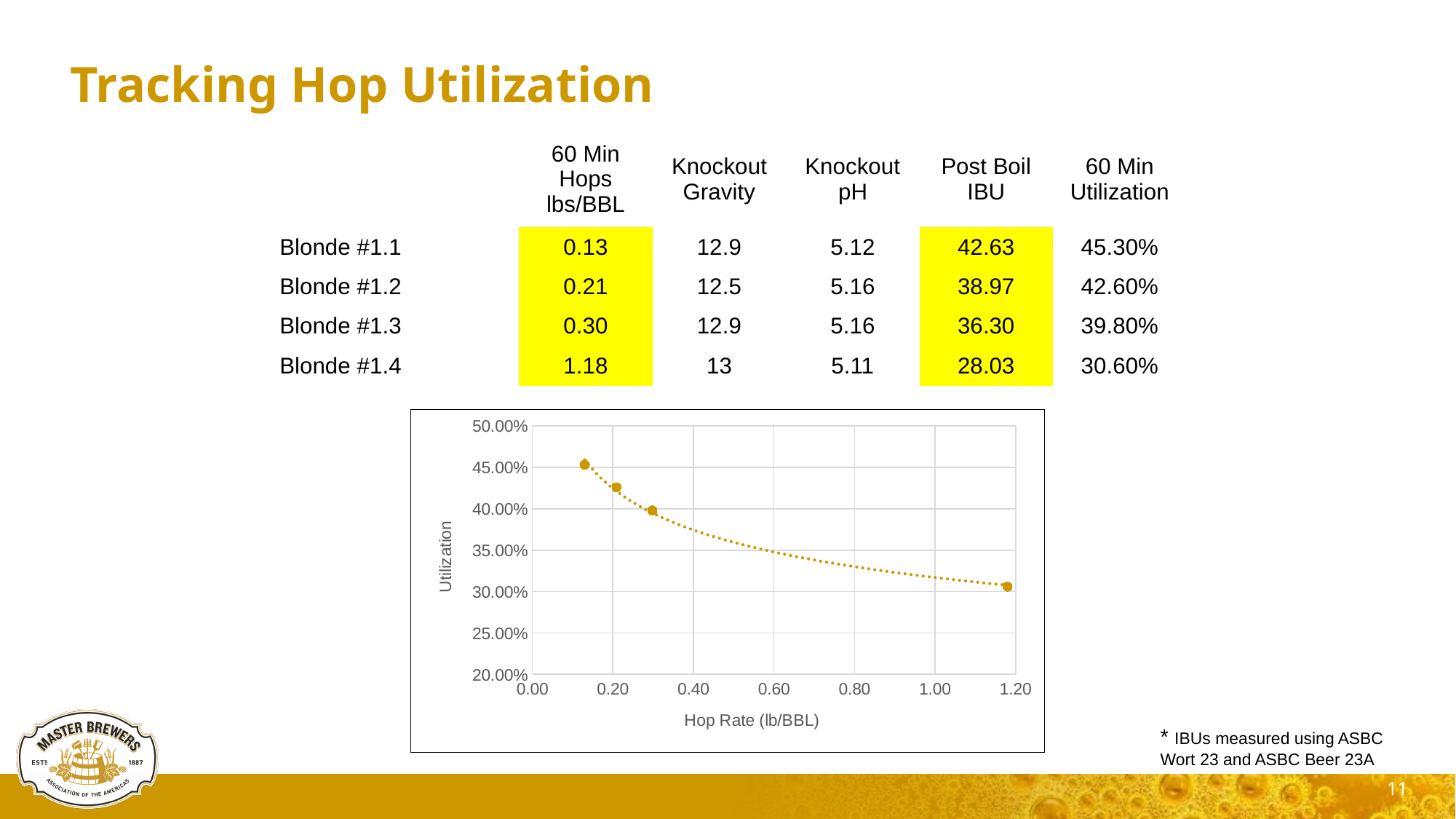
How many data points are plotted on the chart? 4 What is the utilization at a hop rate of 1.18 lb/BBL? 30.60% Which hop rate gives the lowest utilization on the chart? 1.18 Does utilization rise or fall as hop rate increases along the x axis? fall Which hop rate gives the highest utilization on the chart? 0.13 What is the utilization at a hop rate of 0.30 lb/BBL? 39.80% What kind of chart is shown on the slide? scatter chart Is the utilization at a hop rate of 0.21 lb/BBL greater or less than 40.00%? greater What is the label of the x axis of the chart? Hop Rate (lb/BBL) What is the label of the y axis of the chart? Utilization What is the utilization at a hop rate of 0.13 lb/BBL? 45.30% What is the difference in utilization between the 0.13 lb/BBL point and the 1.18 lb/BBL point? 14.70%